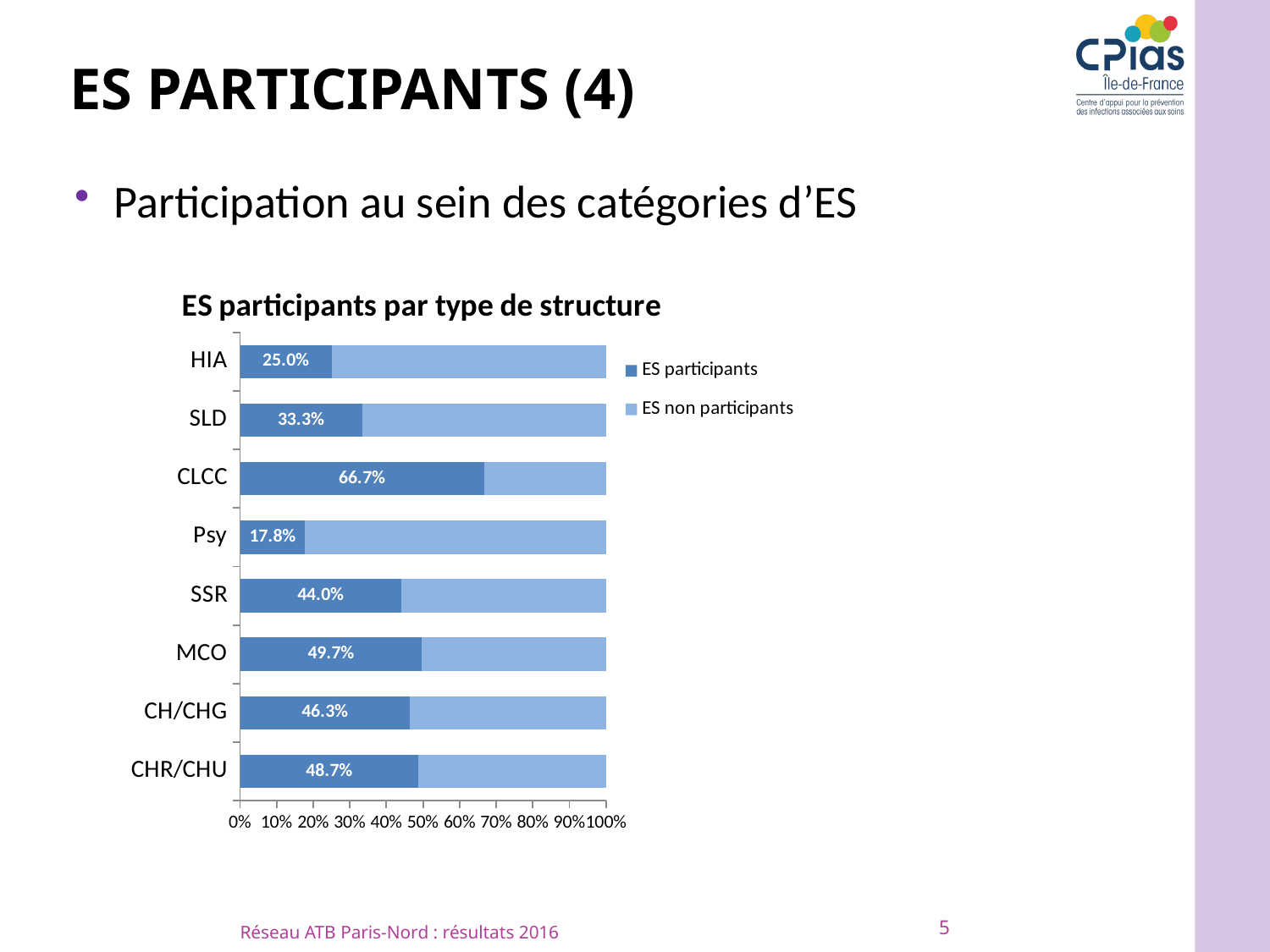
How many types of structure are shown in the chart? 8 Which type of structure has the highest ES participants percentage? CLCC What is the difference between the ES participants percentage for CLCC and for HIA? 41.7% How many series does the legend list? 2 What is the ES participants percentage for SLD? 33.3% Which has a higher ES participants percentage, MCO or CH/CHG? MCO Which type of structure has the lowest ES participants percentage? Psy What is the ES participants percentage for Psy? 17.8% What kind of chart is shown on the slide? Stacked bar chart What is the title of the chart? ES participants par type de structure What is the ES participants percentage for CLCC? 66.7% What is the ES participants percentage for CHR/CHU? 48.7%